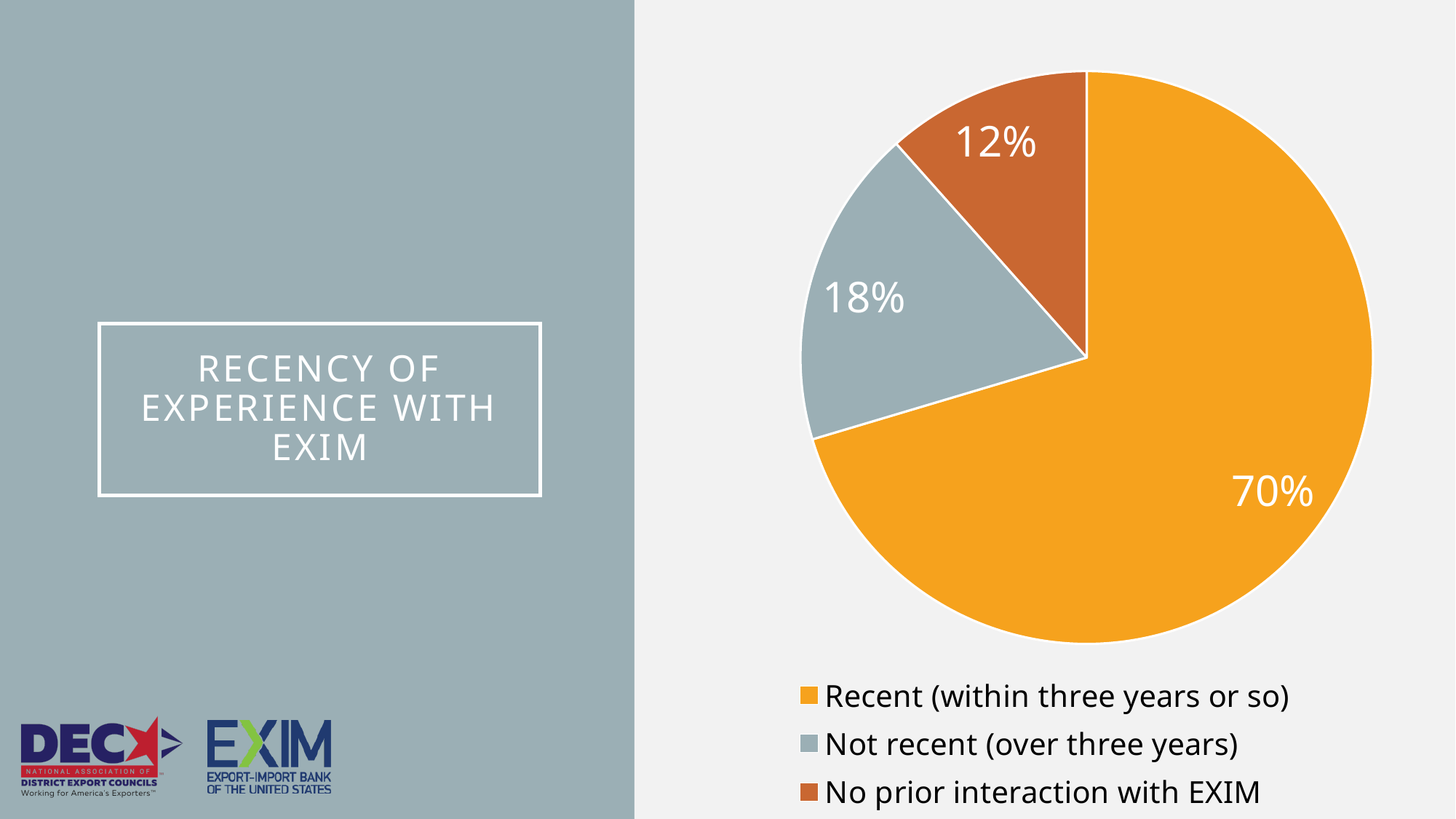
What type of chart is shown on the slide? Pie chart What percentage of respondents reported not recent experience (over three years) with EXIM? 18% Which category has the smallest share of the pie? No prior interaction with EXIM What percentage of respondents reported recent experience (within three years or so) with EXIM? 70% What is the title of the slide containing the chart? Recency of Experience with EXIM Which is larger: the share for 'Not recent (over three years)' or the share for 'No prior interaction with EXIM'? Not recent (over three years) What percentage of respondents reported no prior interaction with EXIM? 12% What is the difference in percentage points between the 'Not recent' and 'No prior interaction with EXIM' slices? 6 What colour is the slice representing 'No prior interaction with EXIM'? Orange-brown Which category has the largest share of the pie? Recent (within three years or so) What is the difference in percentage points between the 'Recent' and 'Not recent' slices? 52 How many slices does the pie chart have? 3